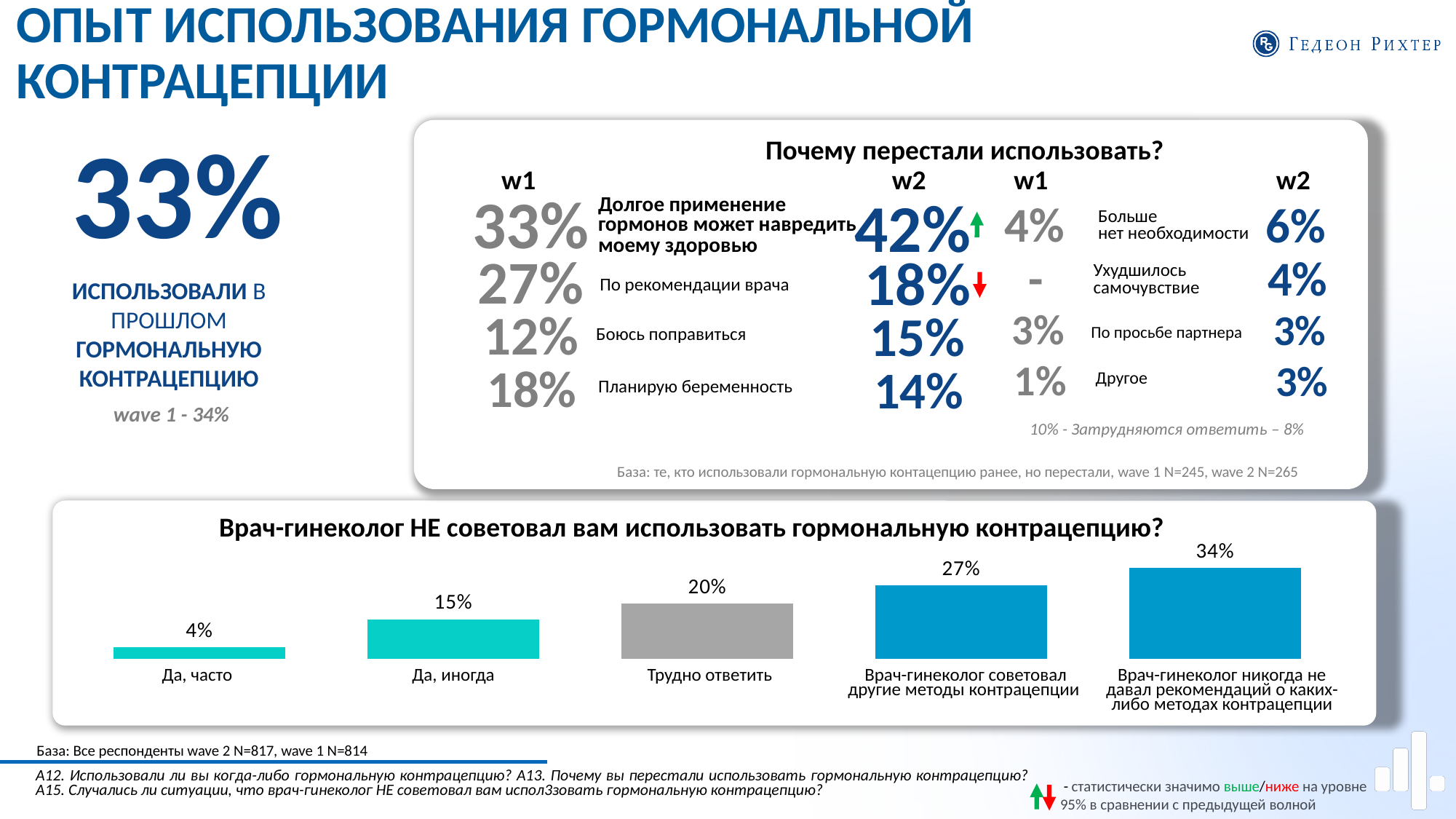
In the chart "Врач-гинеколог НЕ советовал вам использовать гормональную контрацепцию?", what is the difference between the values for "Врач-гинеколог никогда не давал рекомендаций о каких-либо методах контрацепции" and "Да, часто"? 30% In the chart "Врач-гинеколог НЕ советовал вам использовать гормональную контрацепцию?", do the values rise or fall from left to right? Rise In the chart "Врач-гинеколог НЕ советовал вам использовать гормональную контрацепцию?", which is larger: "Да, иногда" or "Трудно ответить"? Трудно ответить In the chart "Врач-гинеколог НЕ советовал вам использовать гормональную контрацепцию?", what is the value for "Трудно ответить"? 20% In the chart "Врач-гинеколог НЕ советовал вам использовать гормональную контрацепцию?", what is the value for "Да, иногда"? 15% How many categories are shown in the chart "Врач-гинеколог НЕ советовал вам использовать гормональную контрацепцию?"? 5 In the chart "Врач-гинеколог НЕ советовал вам использовать гормональную контрацепцию?", what is the value for "Врач-гинеколог советовал другие методы контрацепции"? 27% In the chart "Врач-гинеколог НЕ советовал вам использовать гормональную контрацепцию?", what is the difference between the values for "Трудно ответить" and "Да, иногда"? 5% In the chart "Врач-гинеколог НЕ советовал вам использовать гормональную контрацепцию?", which category has the highest value? Врач-гинеколог никогда не давал рекомендаций о каких-либо методах контрацепции What kind of chart is "Врач-гинеколог НЕ советовал вам использовать гормональную контрацепцию?"? Bar chart In the chart "Врач-гинеколог НЕ советовал вам использовать гормональную контрацепцию?", which category has the lowest value? Да, часто In the chart "Врач-гинеколог НЕ советовал вам использовать гормональную контрацепцию?", what is the value for "Да, часто"? 4%